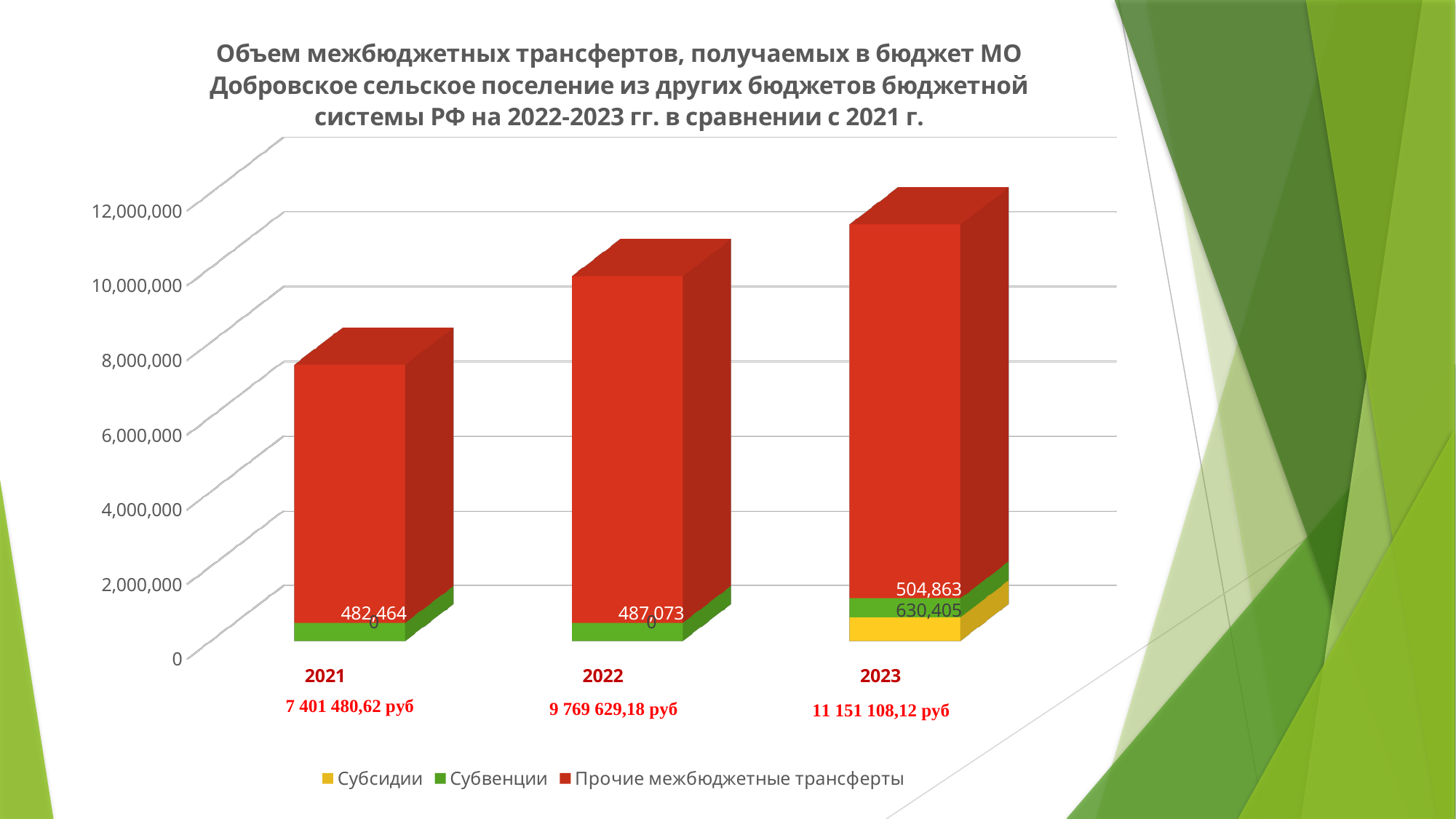
How many series does the legend list? 3 What is the total amount of transfers shown for 2022? 9 769 629,18 руб In 2023, which is larger: Субсидии or Субвенции? Субсидии Which year has the highest total of transfers? 2023 What kind of chart is shown on the slide? Stacked bar chart What is the value of Субвенции for 2021? 482,464 What is the value of Субвенции for 2023? 504,863 What is the value of Субсидии for 2021? 0 What is the value of Субсидии for 2023? 630,405 By how much did Субвенции increase from 2021 to 2023? 22,399 Do the total transfers rise or fall from 2021 to 2023? Rise How many years (categories) are shown on the x axis? 3